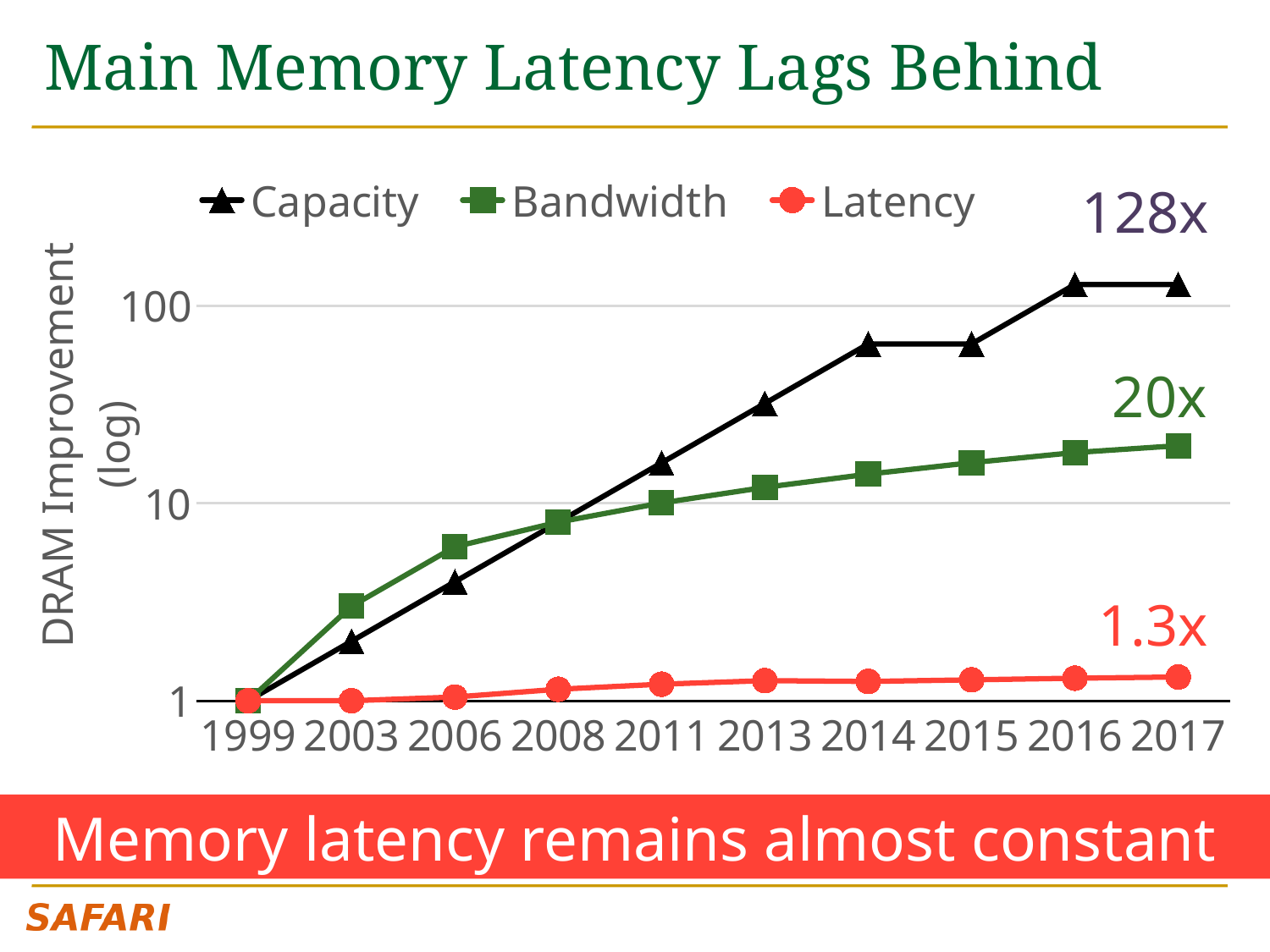
What is the DRAM latency improvement in 2017? 1.3x Which series has the highest value in 2017? Capacity In 2006, which is larger, Bandwidth or Capacity? Bandwidth Does the Capacity series rise or fall from 1999 to 2017? rise What is the label on the y axis? DRAM Improvement (log) Which series has the lowest value in 2017? Latency How many years are shown on the x axis? 10 What is the DRAM capacity improvement in 2017? 128x What kind of chart is shown on the slide? line chart Is the Capacity value for 2016 greater or less than 100? greater What is the DRAM bandwidth improvement in 2017? 20x How many series does the legend list? 3